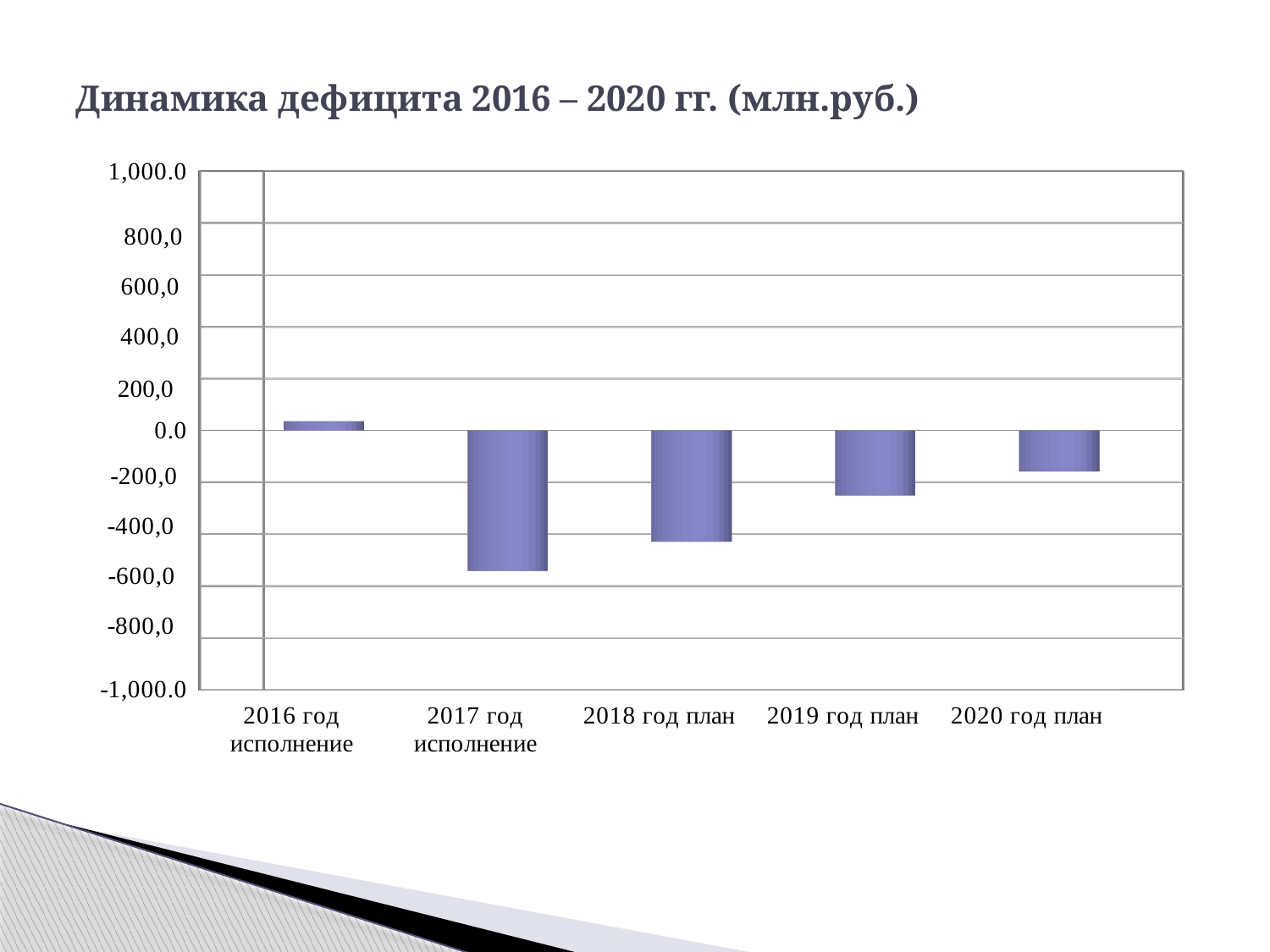
Is the value for 2017 год исполнение greater or less than -400,0? less Which is larger, the value for 2018 год план or the value for 2019 год план? 2019 год план What is the title of the chart? Динамика дефицита 2016 – 2020 гг. (млн.руб.) Which category has the lowest value in the chart? 2017 год исполнение Is the value for 2020 год план greater or less than -200,0? greater Is the value for 2018 год план greater or less than -200,0? less Do the values rise or fall from 2017 год исполнение to 2020 год план? rise Which is larger, the value for 2016 год исполнение or the value for 2020 год план? 2016 год исполнение How many categories are shown on the x axis of the chart? 5 Which category has the highest value in the chart? 2016 год исполнение What kind of chart is shown on the slide? bar chart